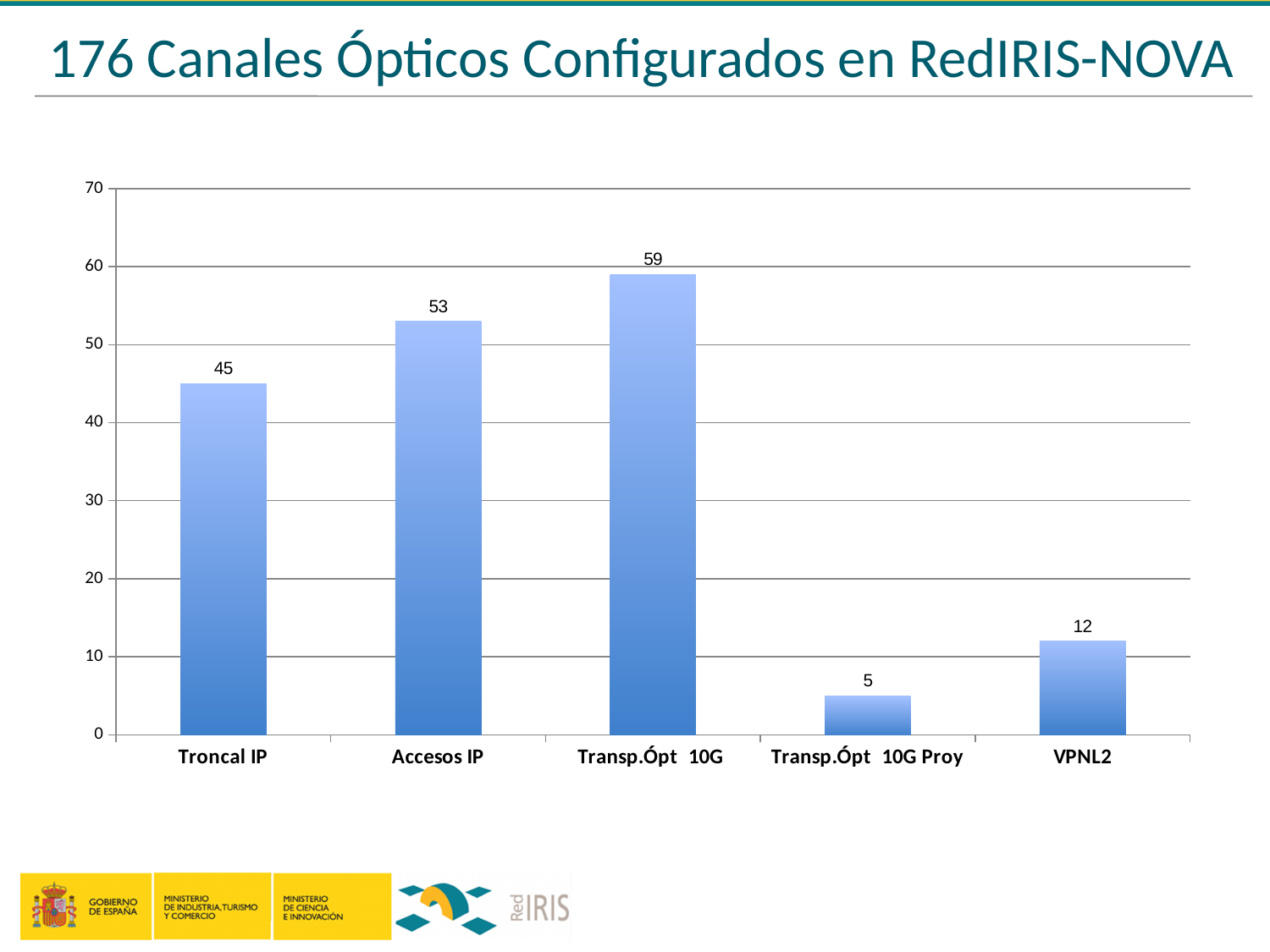
What is the difference between the values for Transp.Ópt 10G and Troncal IP? 14 What is the value for Troncal IP? 45 What kind of chart is shown on the slide? bar chart What is the value for VPNL2? 12 What is the title of the slide? 176 Canales Ópticos Configurados en RedIRIS-NOVA Which category has the lowest value? Transp.Ópt 10G Proy What is the value for Accesos IP? 53 How many categories are shown on the x axis? 5 What is the value for Transp.Ópt 10G Proy? 5 Which is larger, the value for Accesos IP or the value for VPNL2? Accesos IP Which category has the highest value? Transp.Ópt 10G Is the value for Accesos IP greater or less than 50? greater